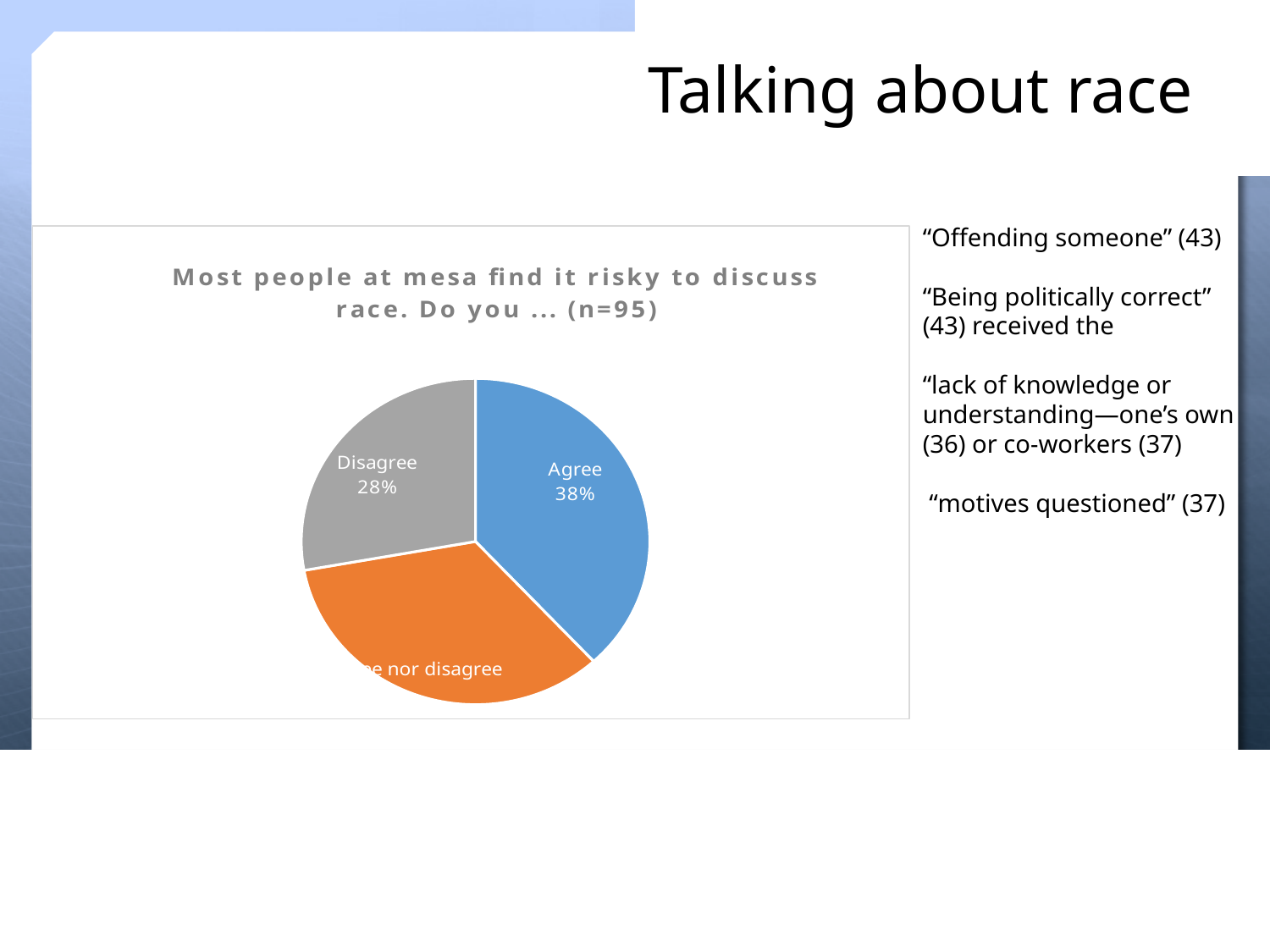
What colour is the Agree slice of the pie chart? Blue What kind of chart is shown on the slide? Pie chart What is the difference in percentage points between the Agree and Disagree slices? 10 percentage points How many slices does the pie chart have? 3 What share of the pie does the Agree slice represent? 38% Which slice is larger, Agree or Disagree? Agree Which of the labelled slices, Agree or Disagree, is the smallest slice of the pie? Disagree What is the sample size (n) given in the chart title? 95 What percentage of respondents chose Agree in the pie chart? 38% What percentage of respondents chose Disagree in the pie chart? 28%